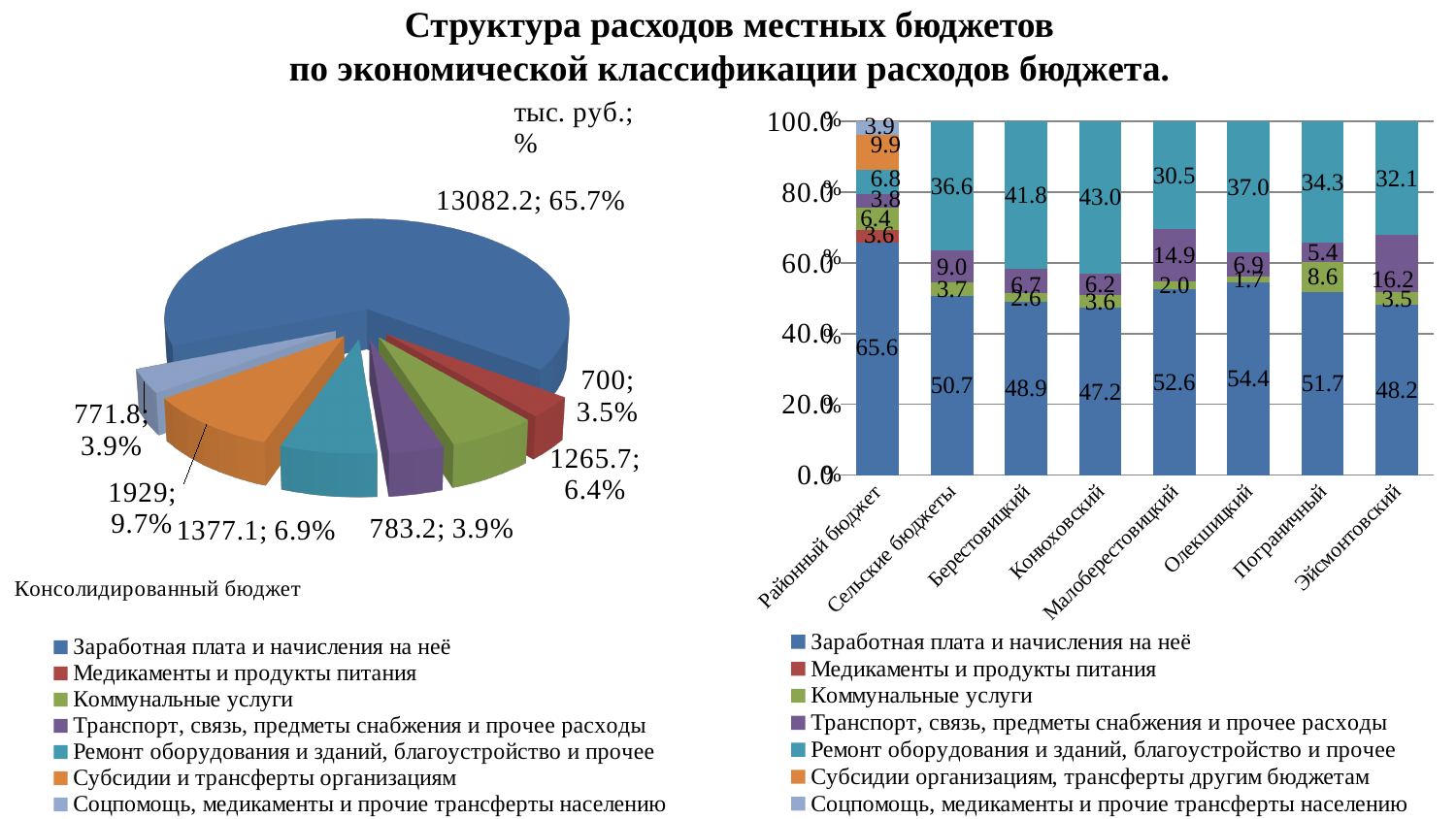
In the pie chart (Консолидированный бюджет), what value and share are shown for Заработная плата и начисления на неё? 13082.2; 65.7% In the stacked bar chart on the right, what is the value of Ремонт оборудования и зданий, благоустройство и прочее for Коноховский? 43.0 In the stacked bar chart on the right, which category has the highest value for Заработная плата и начисления на неё? Районный бюджет In the pie chart (Консолидированный бюджет), what share does Субсидии и трансферты организациям have? 9.7% How many categories are shown on the x axis of the stacked bar chart on the right? 8 In the stacked bar chart on the right, which category has the lowest value for Заработная плата и начисления на неё? Коноховский In the stacked bar chart on the right, which has the larger value for Транспорт, связь, предметы снабжения и прочее расходы: Эйсмонтовский or Малоберестовицкий? Эйсмонтовский In the stacked bar chart on the right, what is the difference between the Ремонт оборудования и зданий, благоустройство и прочее values for Коноховский and Малоберестовицкий? 12.5 In the pie chart (Консолидированный бюджет), what value is shown for Медикаменты и продукты питания? 700; 3.5% How many slices does the pie chart (Консолидированный бюджет) have? 7 In the stacked bar chart on the right, what is the value of Заработная плата и начисления на неё for Олекшицкий? 54.4 What kind of chart is the chart on the right of the slide? Stacked bar chart